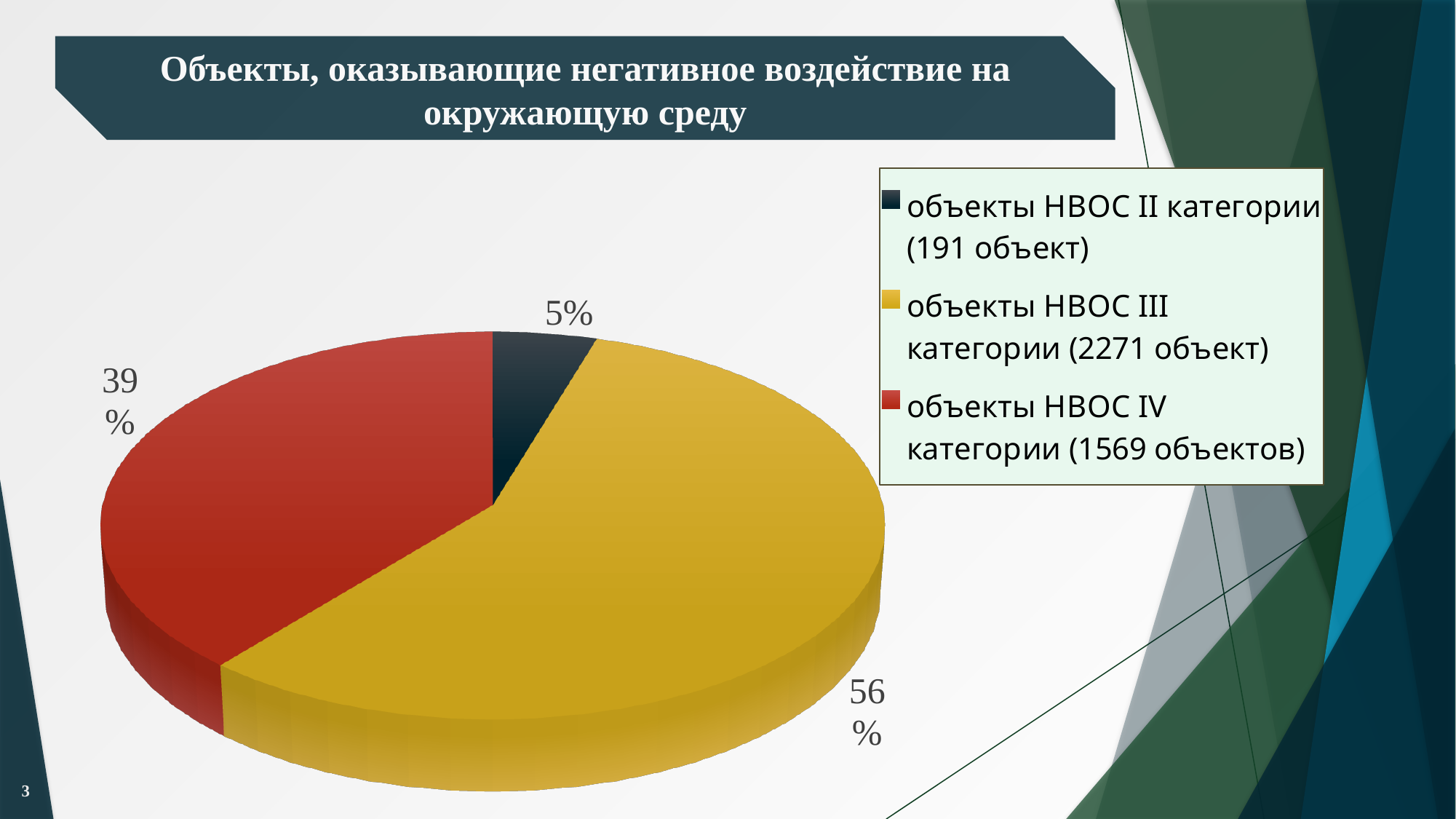
What is the difference in percentage points between the slices for объекты НВОС III категории and объекты НВОС IV категории? 17 What share of the pie does the slice for объекты НВОС II категории take? 5% Which slice is larger: объекты НВОС IV категории or объекты НВОС II категории? объекты НВОС IV категории What share of the pie does the slice for объекты НВОС IV категории take? 39% According to the legend, how many objects belong to объекты НВОС III категории? 2271 How many entries does the legend list? 3 Which category has the smallest slice of the pie? объекты НВОС II категории What share of the pie does the slice for объекты НВОС III категории take? 56% What colour is the slice for объекты НВОС IV категории? red How many slices does the pie chart have? 3 What type of chart is shown on the slide? pie chart Which category has the largest slice of the pie? объекты НВОС III категории